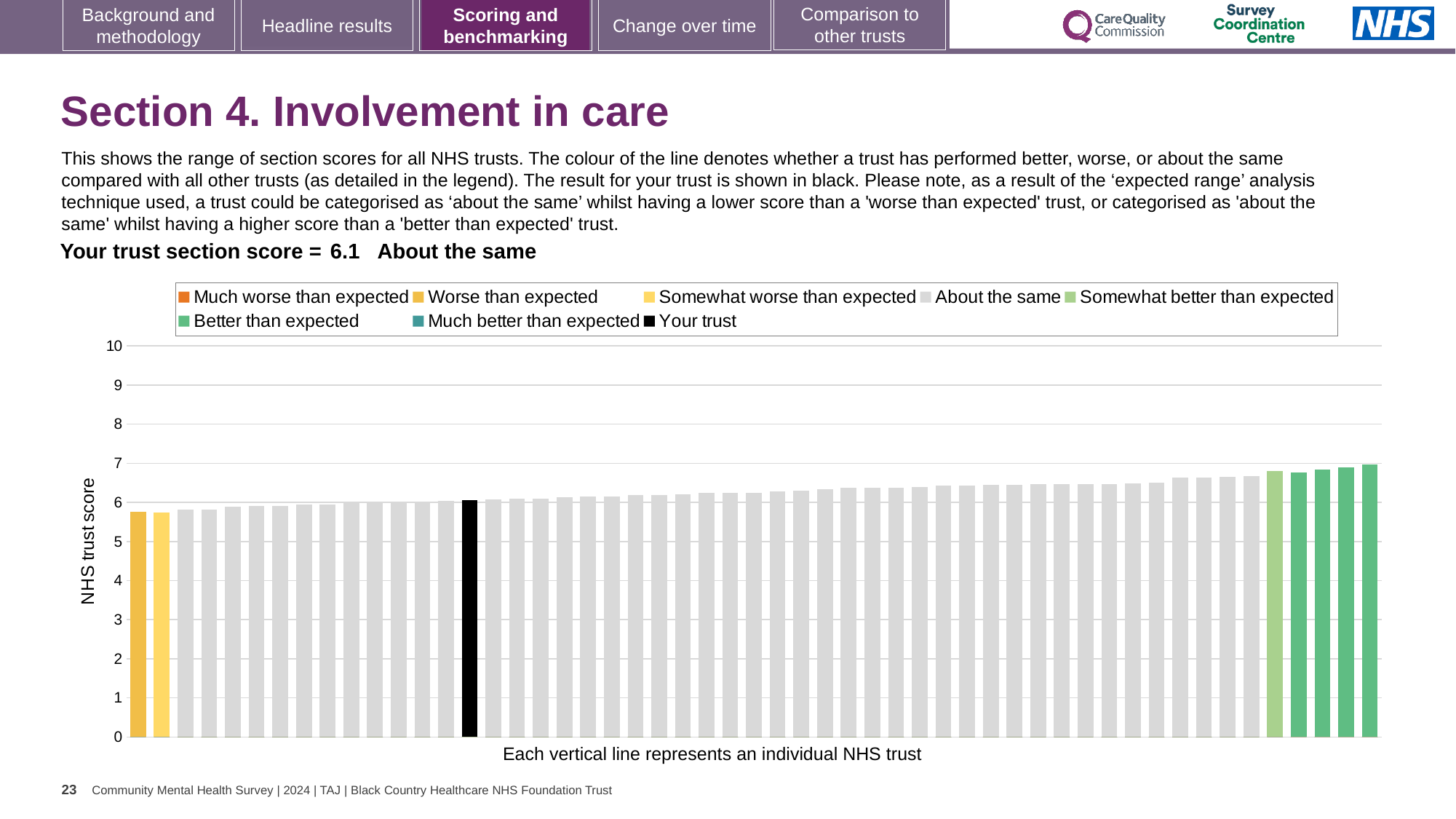
How many entries does the chart legend list? 8 Do the bar values rise or fall from left to right along the x axis? rise What kind of chart is shown on the slide? bar chart What is the label on the vertical axis of the chart? NHS trust score What colour is used to show your trust in the chart? black Which category does your trust fall into according to the slide? About the same What is the section score for your trust shown on the slide? 6.1 Is the value of the leftmost bar greater or less than 6? less How many bars are coloured dark green (Better than expected)? 4 Is the value of the leftmost bar greater or less than 5? greater